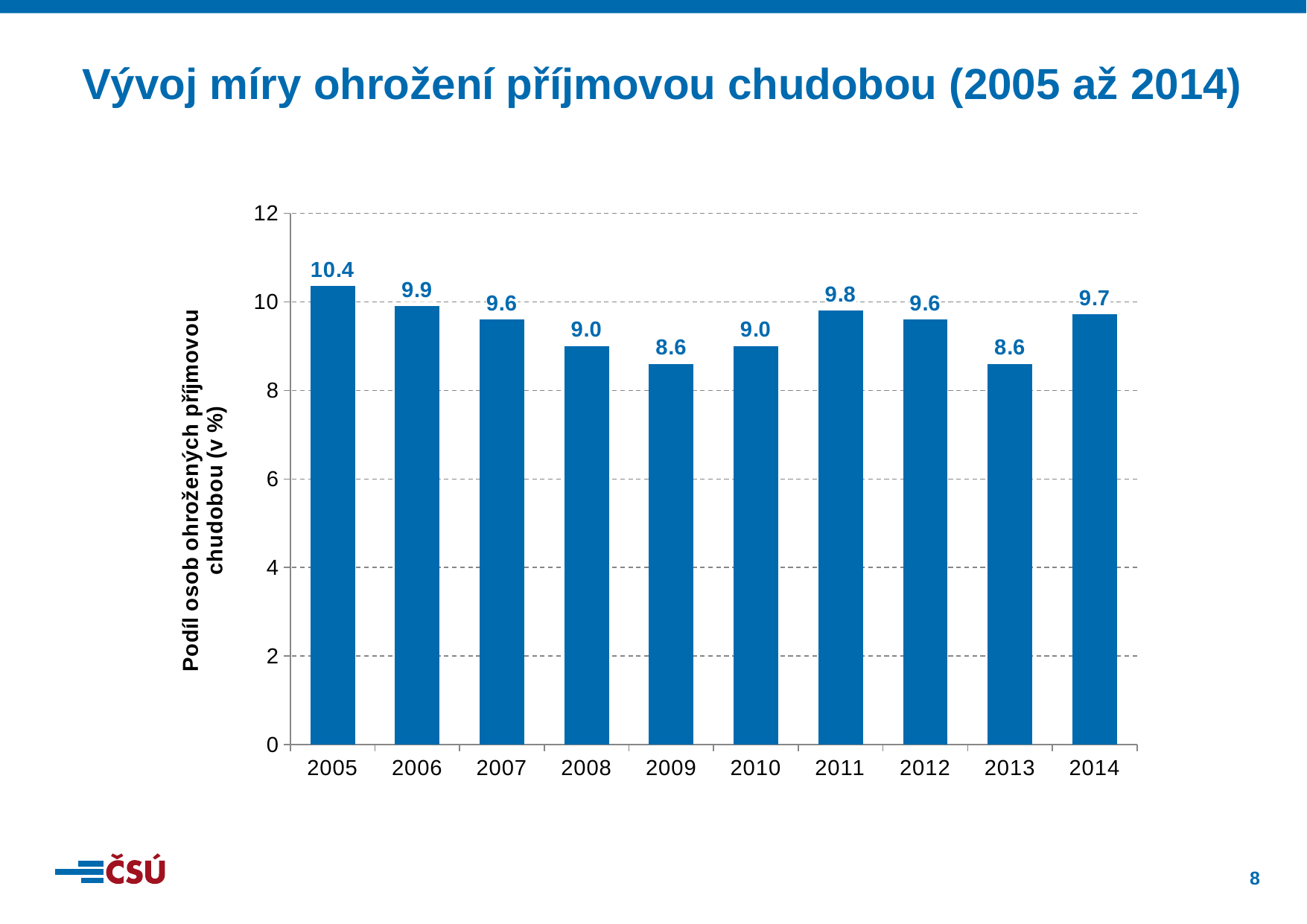
What kind of chart is shown on the slide? bar chart Is the value for 2008 greater or less than 10? less How many years are shown on the x axis? 10 Do the values rise or fall from 2005 to 2009? fall What is the lowest value shown in the chart? 8.6 What is the label of the vertical axis? Podíl osob ohrožených příjmovou chudobou (v %) What is the difference between the values for 2005 and 2009? 1.8 Which year has the highest value? 2005 What is the value for 2011? 9.8 What is the value for 2005? 10.4 Which is larger, the value for 2006 or the value for 2012? 2006 What is the value for 2014? 9.7